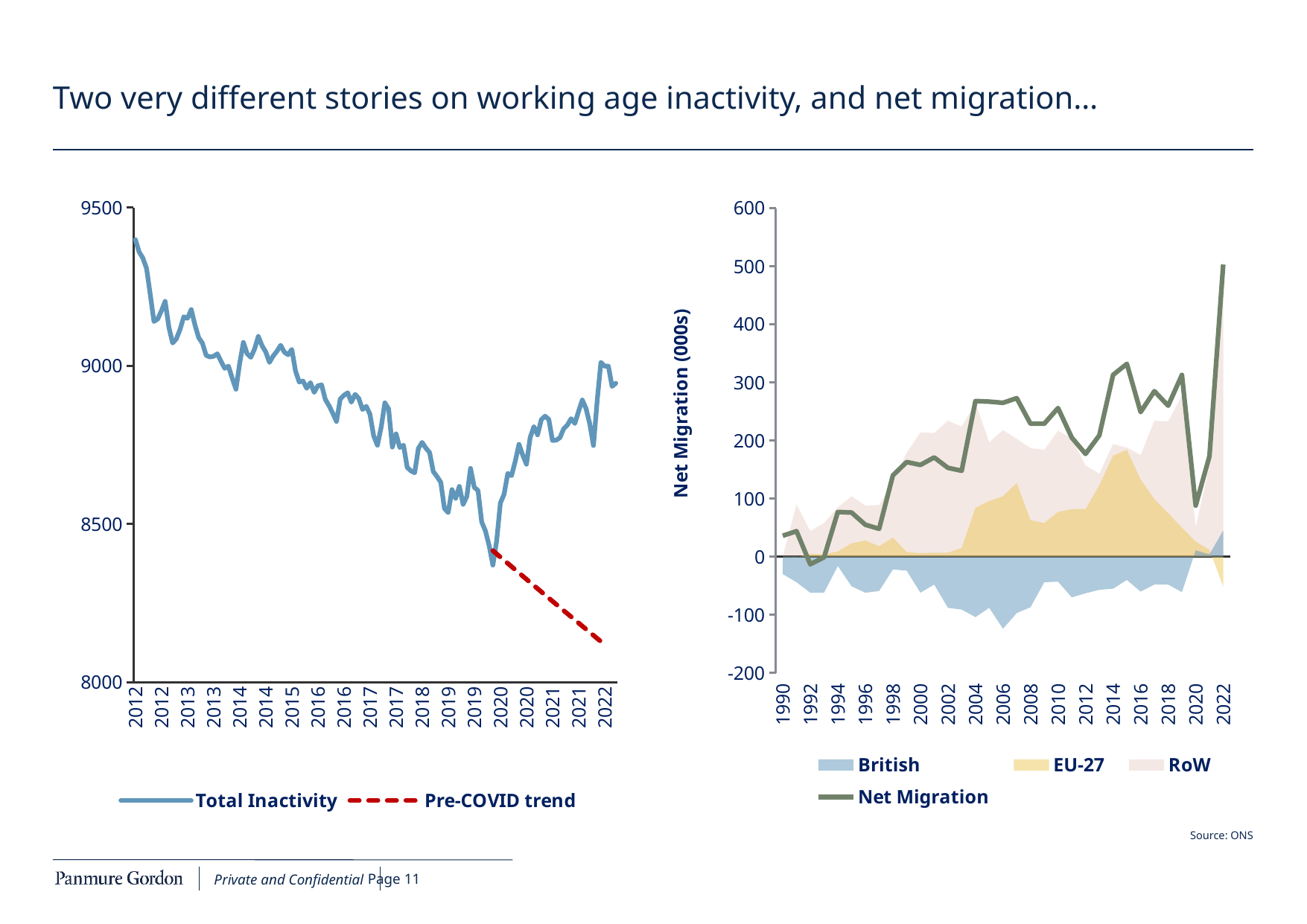
In the left chart, what colour and style is the Pre-COVID trend line? red dashed In the right chart, in which year is Net Migration highest? 2022 How many series does the legend of the right chart (Net Migration) list? 4 In the left chart, is the Total Inactivity value at the start of 2012 greater or less than 9000? greater In the right chart, which is larger: Net Migration in 2022 or in 2020? 2022 What is the y-axis label of the right chart? Net Migration (000s) How many series does the legend of the left chart list? 2 In the right chart, is the Net Migration value in 2022 greater or less than 400? greater In the left chart, is the lowest Total Inactivity value in 2020 greater or less than 8500? less In the left chart, does Total Inactivity rise or fall between 2012 and 2019? fall What kind of chart is the left chart showing Total Inactivity? line chart